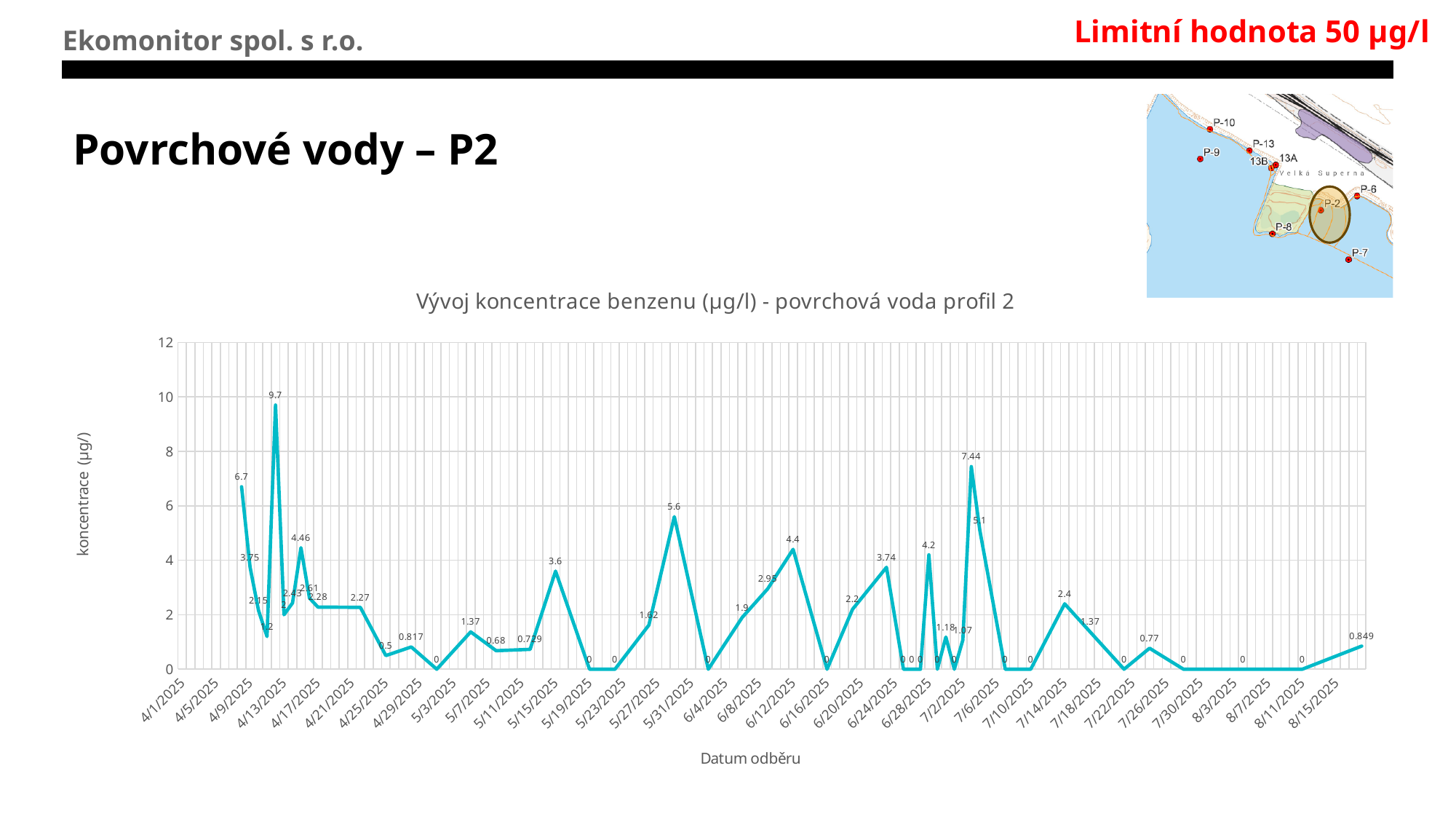
What is the value of the second-highest peak on the chart, in early July 2025? 7.44 What is the lowest value labelled on the chart? 0 What is the title of the chart? Vývoj koncentrace benzenu (µg/l) - povrchová voda profil 2 Is the highest value on the chart greater or less than 10? less Is the peak at the end of May 2025 (5.6) higher or lower than the peak around 6/12/2025 (4.4)? higher What is the highest value labelled on the chart? 9.7 Is the value at the end of the series (mid-August) higher or lower than the value at the start (early April)? lower What kind of chart is shown on the slide? line chart What is the value of the last data point on the chart (mid-August 2025)? 0.849 What is the label of the vertical axis of the chart? koncentrace (µg/l) What is the value of the first data point on the chart (early April 2025)? 6.7 What is the difference between the highest peak (9.7) and the early-July peak (7.44)? 2.26